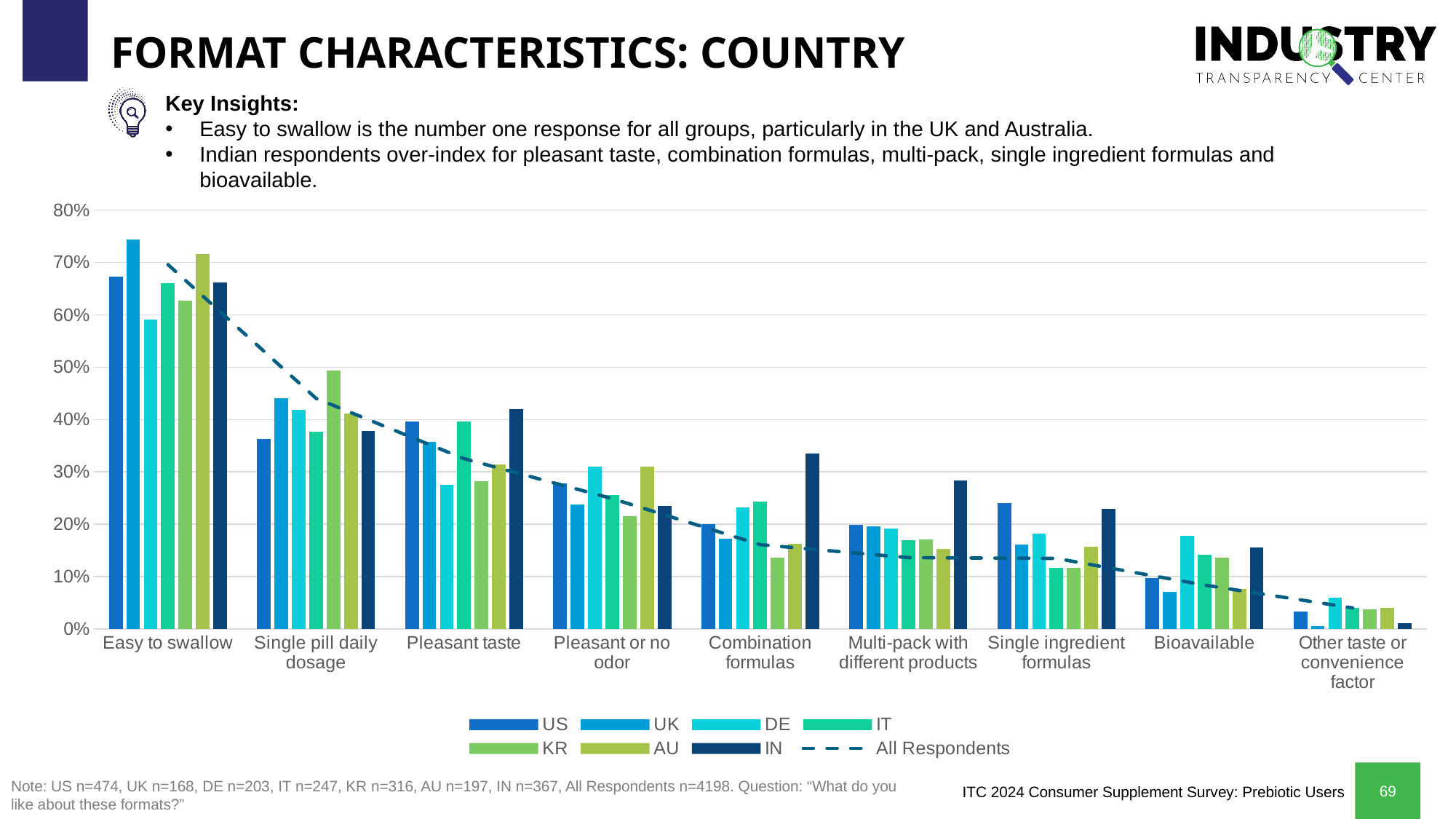
For Bioavailable, which is larger: the DE bar or the UK bar? DE For Combination formulas, which country has the highest bar? IN For Single pill daily dosage, which country has the highest bar? KR For Combination formulas, which country has the lowest bar? KR How many series does the legend list? 8 Does the All Respondents dashed line rise or fall from left to right across the categories? fall For Easy to swallow, which country has the highest bar? UK Is the value for IN on Combination formulas greater or less than 30%? greater How many format characteristic categories are shown along the x axis? 9 Is the value for US on Pleasant taste greater or less than 30%? greater What kind of chart is shown on the slide? combination bar and line chart Is the value for UK on Easy to swallow greater or less than 70%? greater